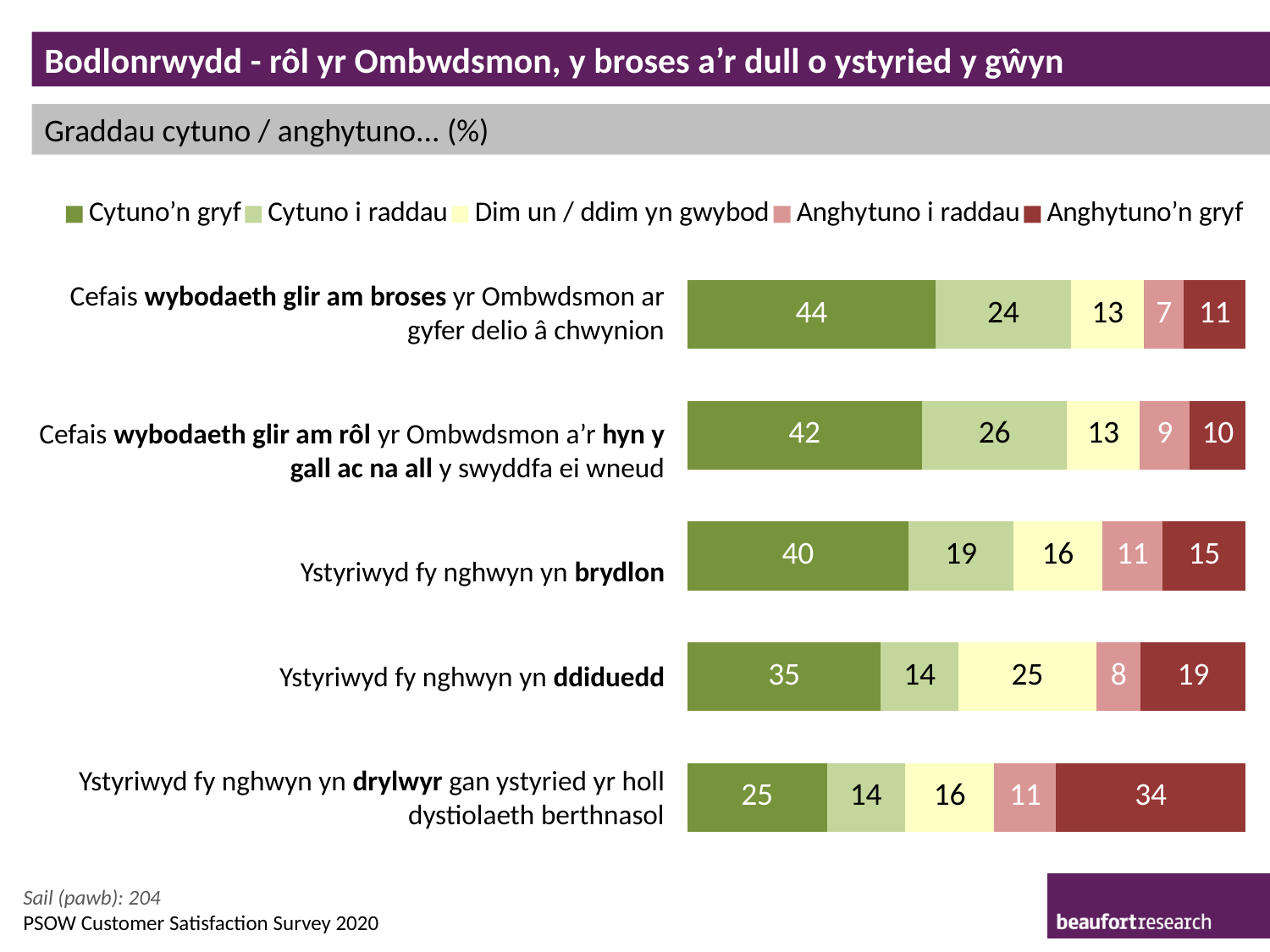
What is the total of the stacked bar for 'Cefais wybodaeth glir am rôl yr Ombwdsmon a'r hyn y gall ac na all y swyddfa ei wneud'? 100 Which is larger: the 'Anghytuno'n gryf' value for 'Ystyriwyd fy nghwyn yn ddiduedd' or for 'Ystyriwyd fy nghwyn yn brydlon'? Ystyriwyd fy nghwyn yn ddiduedd Which statement has the highest 'Cytuno'n gryf' value? Cefais wybodaeth glir am broses yr Ombwdsmon ar gyfer delio â chwynion What type of chart is shown on the slide? Stacked bar chart What is the 'Dim un / ddim yn gwybod' value for 'Ystyriwyd fy nghwyn yn ddiduedd'? 25 What is the 'Cytuno'n gryf' value for 'Ystyriwyd fy nghwyn yn brydlon'? 40 What is the 'Anghytuno'n gryf' value for 'Ystyriwyd fy nghwyn yn drylwyr gan ystyried yr holl dystiolaeth berthnasol'? 34 What is the sample size (Sail) stated on the slide? 204 How many statements (bars) are plotted in the chart? 5 Which statement has the lowest 'Cytuno'n gryf' value? Ystyriwyd fy nghwyn yn drylwyr gan ystyried yr holl dystiolaeth berthnasol How many series does the legend list? 5 What is the difference between the 'Cytuno i raddau' values for 'Cefais wybodaeth glir am rôl yr Ombwdsmon...' and 'Ystyriwyd fy nghwyn yn ddiduedd'? 12